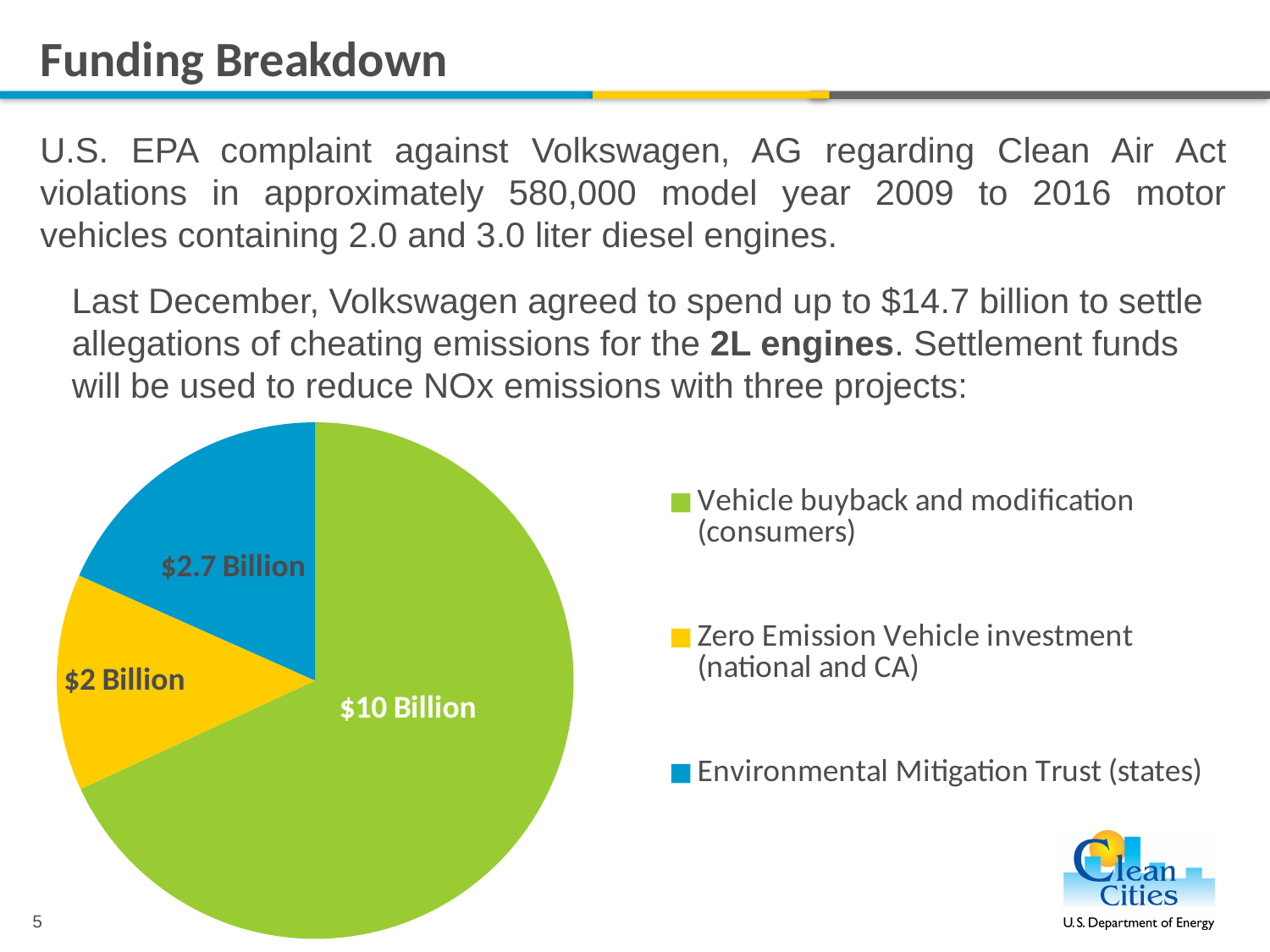
Which category receives the largest share of funding in the pie chart? Vehicle buyback and modification (consumers) What colour is the Environmental Mitigation Trust (states) slice? Blue What is the value of the Zero Emission Vehicle investment (national and CA) slice? $2 Billion How many entries does the legend of the pie chart list? 3 What is the value of the Environmental Mitigation Trust (states) slice? $2.7 Billion What kind of chart is shown on the slide? Pie chart How many slices does the pie chart have? 3 Which is larger: the Environmental Mitigation Trust (states) slice or the Zero Emission Vehicle investment slice? Environmental Mitigation Trust (states) What is the value of the Vehicle buyback and modification (consumers) slice? $10 Billion What is the difference between the Vehicle buyback and modification slice and the Environmental Mitigation Trust slice? $7.3 Billion Which category receives the smallest share of funding in the pie chart? Zero Emission Vehicle investment (national and CA) What is the total of all three slices in the pie chart? $14.7 Billion